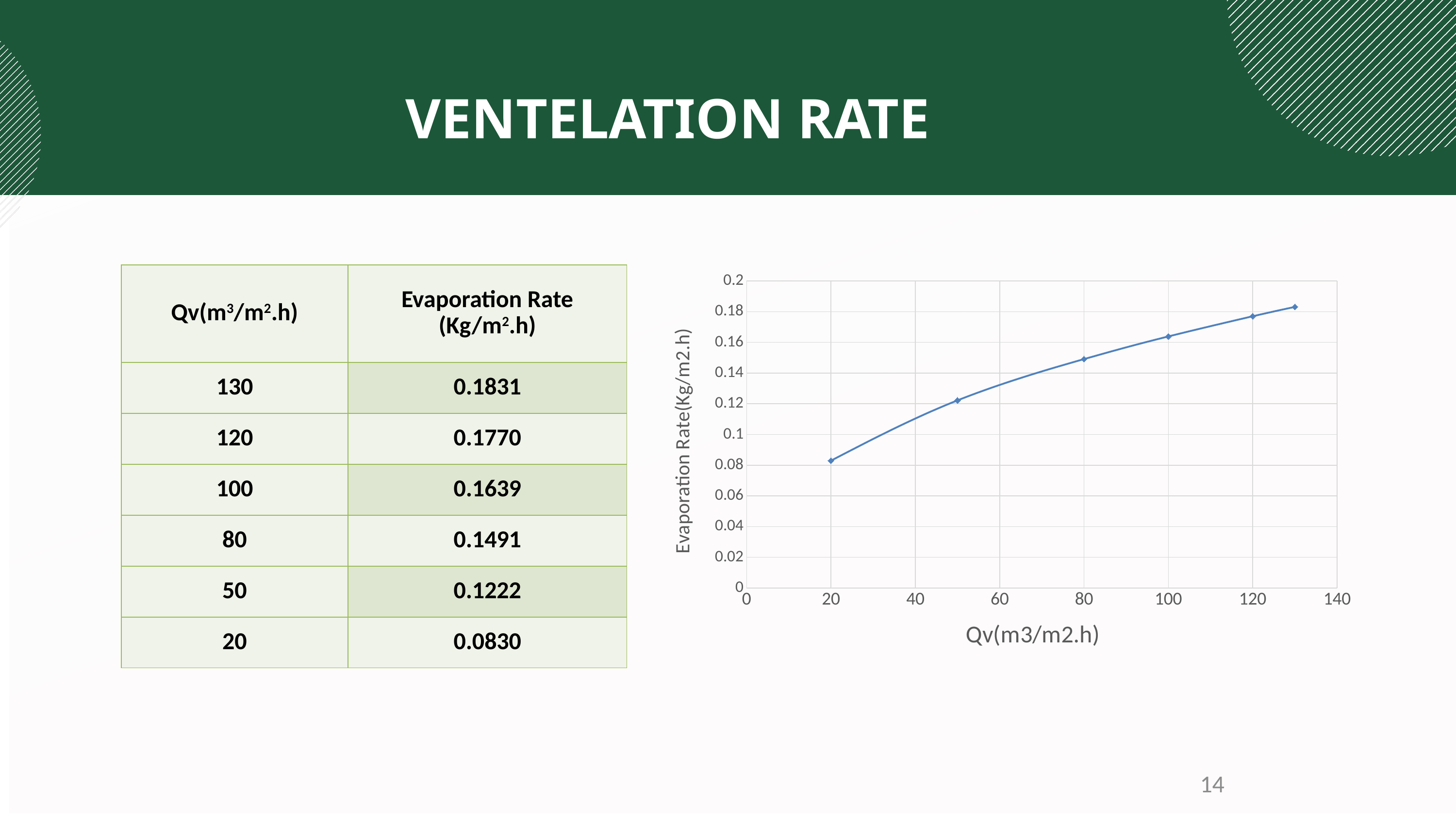
Is the evaporation rate at Qv = 130 greater or less than 0.16? greater Is the evaporation rate at Qv = 80 greater or less than 0.14? greater According to the table, what is the evaporation rate at Qv = 130? 0.1831 Does the evaporation rate rise or fall as Qv increases along the x axis? rise According to the table, what is the evaporation rate at Qv = 80? 0.1491 At which Qv value is the evaporation rate lowest on the chart? 20 Which has the larger evaporation rate on the chart, Qv = 50 or Qv = 100? Qv = 100 What is the label of the chart's x axis? Qv(m3/m2.h) How many data points are plotted on the line chart? 6 Is the evaporation rate at Qv = 20 greater or less than 0.1? less At which Qv value is the evaporation rate highest on the chart? 130 What kind of chart is shown on the slide? line chart